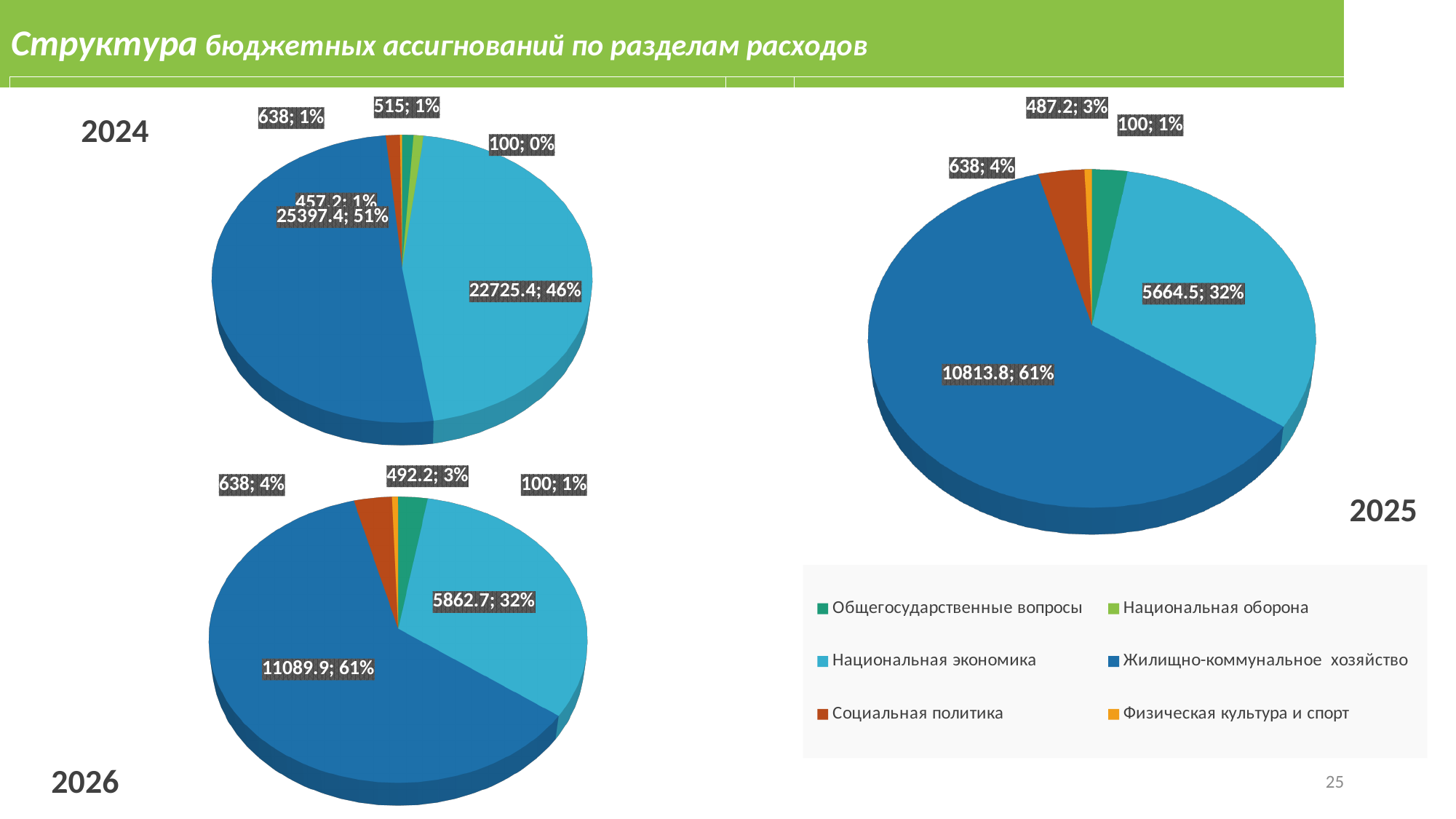
In the 2026 chart, which category has the smallest slice? Физическая культура и спорт In the 2025 chart, what share of the pie does Жилищно-коммунальное хозяйство have? 61% What kind of charts are shown on the slide? Pie charts In the 2024 chart, what is the value shown for Жилищно-коммунальное хозяйство? 25397.4 In the 2025 chart, what is the value shown for Национальная экономика? 5664.5 In the 2026 chart, which is larger: the value for Социальная политика or the value for Общегосударственные вопросы? Социальная политика In the 2024 chart, what share of the pie does Национальная экономика have? 46% How many entries does the legend list? 6 In the 2026 chart, what is the value shown for Социальная политика? 638 In the 2024 chart, what is the difference between the values for Жилищно-коммунальное хозяйство and Национальная экономика? 2672 In the 2026 chart, what is the value shown for Жилищно-коммунальное хозяйство? 11089.9 In the 2025 chart, which category has the largest slice? Жилищно-коммунальное хозяйство